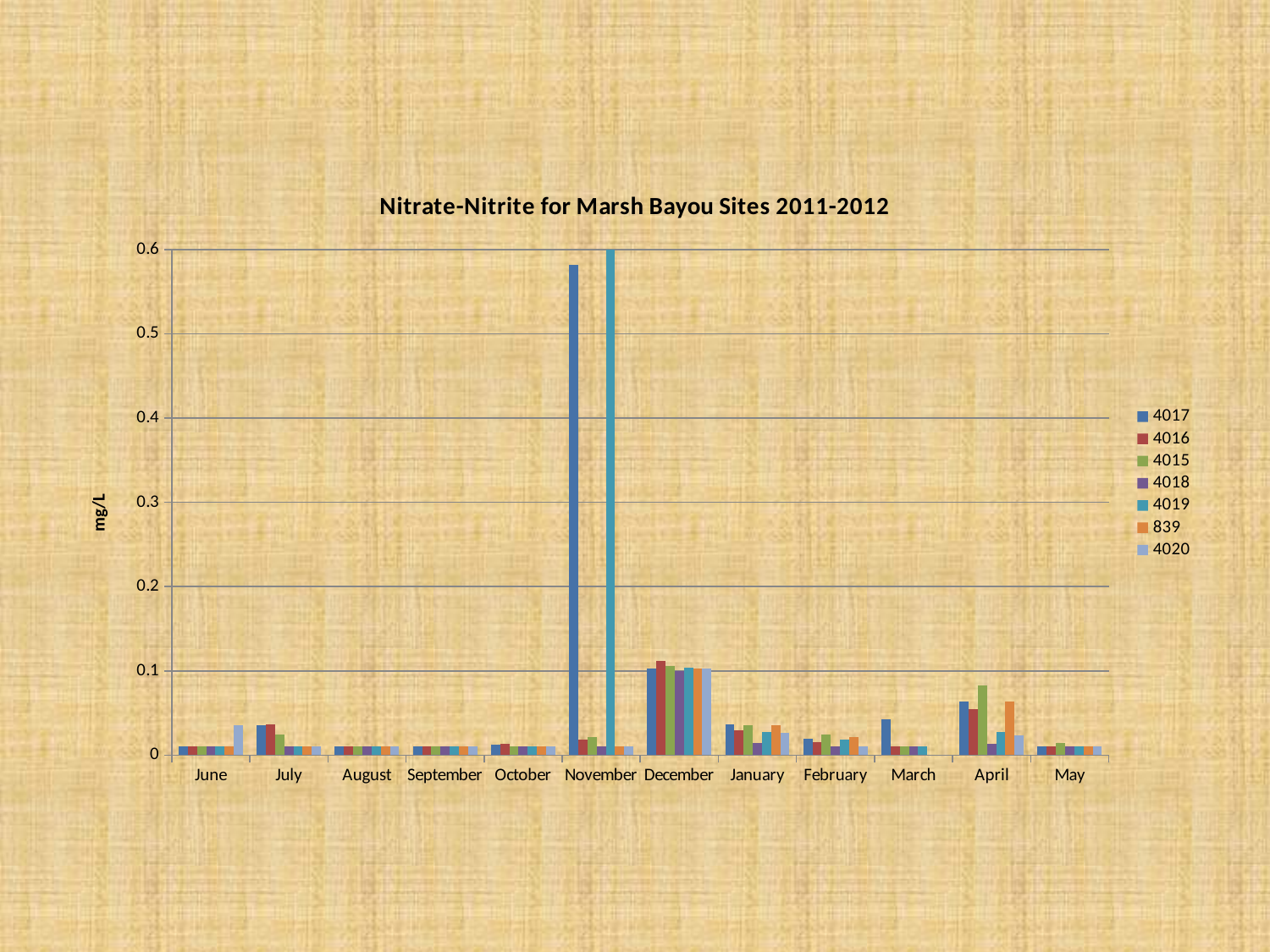
What type of chart is shown on the slide? bar chart In November, which is larger: the value for site 4017 or the value for site 4016? 4017 How many series does the legend list? 7 In which month does the tallest bar on the chart occur? November Is the value for site 4016 in December greater or less than 0.2? less How many months are shown along the x axis? 12 Is the value for site 4019 in November greater or less than 0.4? greater Is the value for site 4017 in November greater or less than 0.5? greater What is the label on the vertical axis? mg/L Which series has the highest value in March? 4017 Which series has the highest value in April? 4015 What is the title of the chart? Nitrate-Nitrite for Marsh Bayou Sites 2011-2012